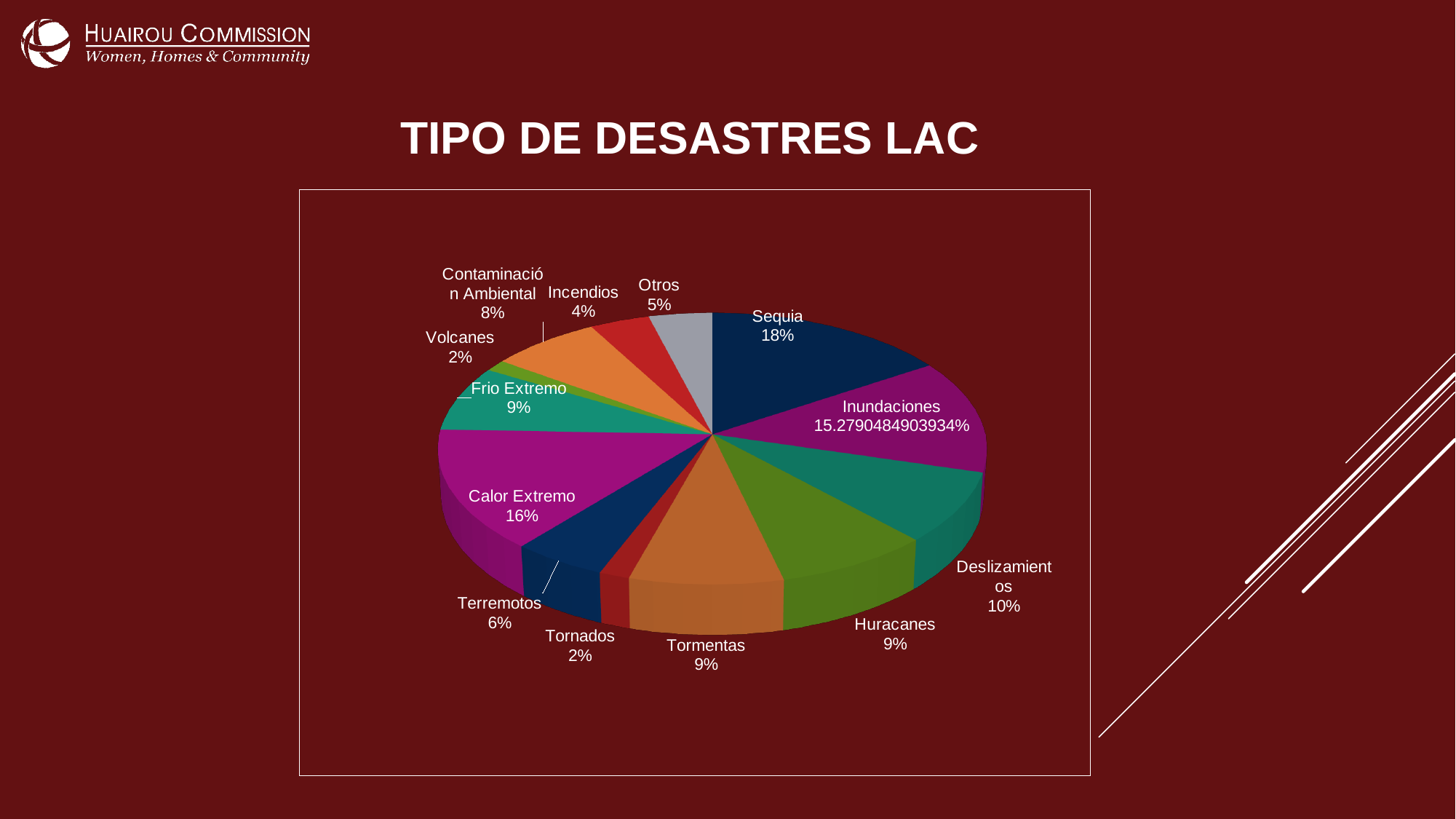
What is the title of the chart? TIPO DE DESASTRES LAC Which category has the largest share of the pie? Sequia What share of the pie does Sequia represent? 18% What percentage is shown for Calor Extremo? 16% What percentage is shown for Frio Extremo? 9% What value is shown for Inundaciones? 15.2790484903934% What is the difference between the shares of Contaminación Ambiental and Otros? 3% What percentage is shown for Deslizamientos? 10% How many categories are shown in the pie chart? 13 What type of chart is shown on the slide? Pie chart What is the difference between the shares of Sequia and Calor Extremo? 2% Which is larger, the share for Terremotos or the share for Incendios? Terremotos